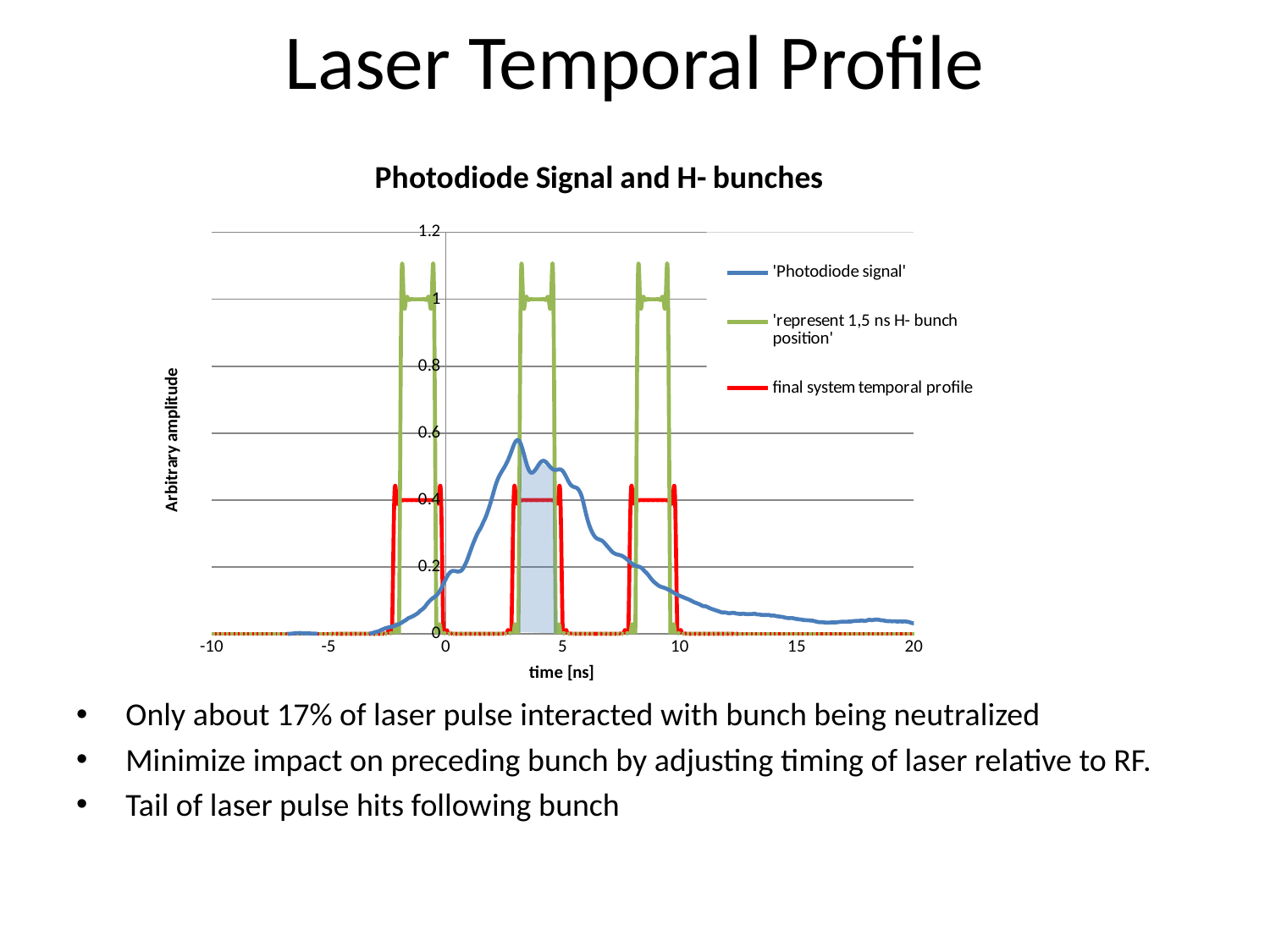
What is the title of the chart? Photodiode Signal and H- bunches What is the label of the x axis? time [ns] Which series reaches the highest amplitude on the chart? 'represent 1,5 ns H- bunch position' Is the peak value of the 'Photodiode signal' series greater or less than 0.4? greater What is the plateau value of the 'represent 1,5 ns H- bunch position' series? 1 Is the peak value of the 'Photodiode signal' series greater or less than 0.8? less How many series does the chart legend list? 3 What kind of chart is shown on the slide? line chart Is the value of the 'Photodiode signal' series at time 15 ns greater or less than 0.2? less Does the 'Photodiode signal' series rise or fall between 5 ns and 20 ns? fall What is the plateau value of the 'final system temporal profile' series? 0.4 How many separate pulses does the 'final system temporal profile' series show? 3